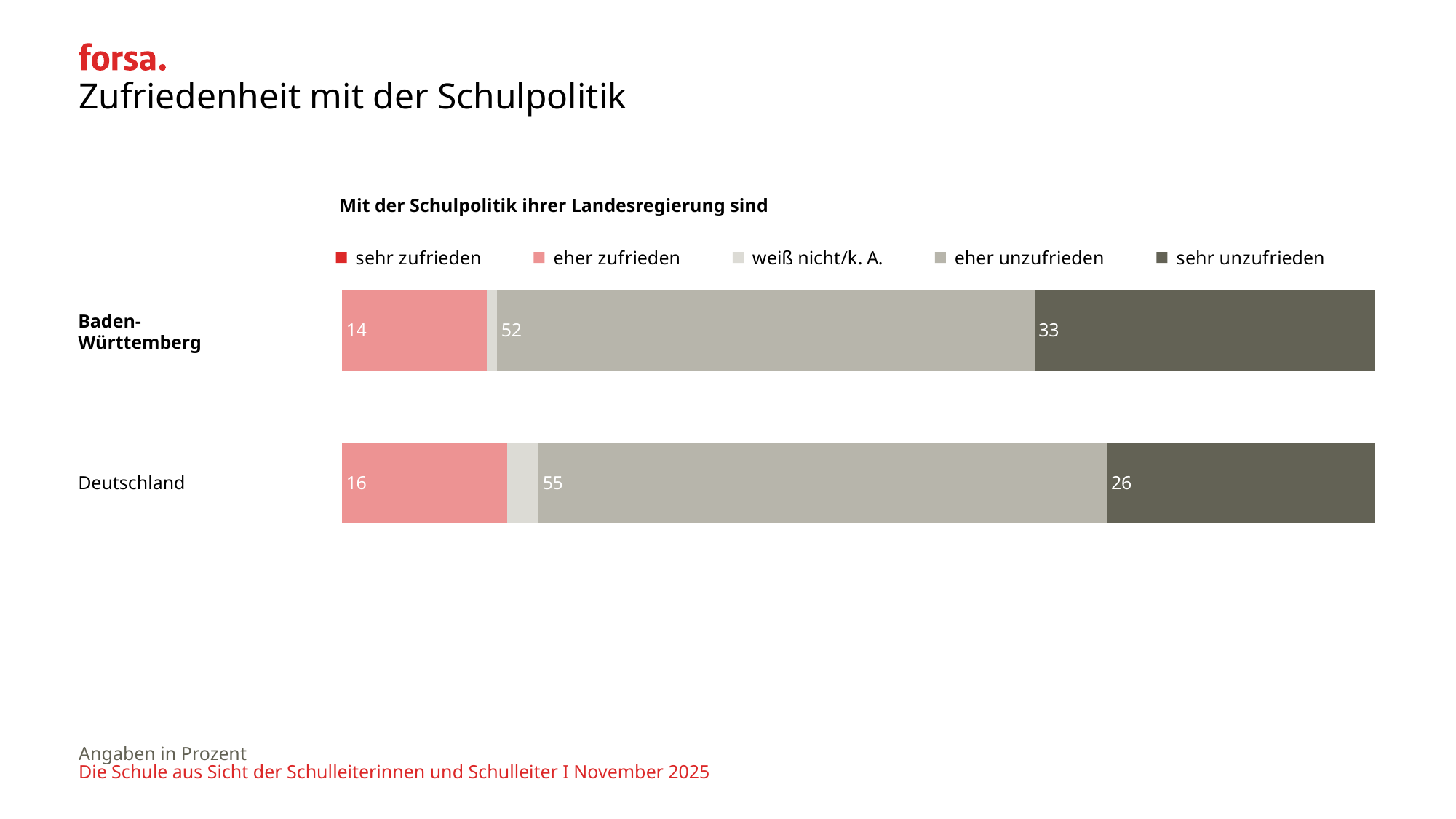
What is the value for "sehr unzufrieden" for Deutschland? 26 What is the difference between the "eher unzufrieden" values for Deutschland and Baden-Württemberg? 3 What is the value for "eher unzufrieden" for Deutschland? 55 How many series does the legend list? 5 What kind of chart is shown on the slide? Stacked bar chart What is the value for "eher zufrieden" for Deutschland? 16 What is the value for "eher unzufrieden" for Baden-Württemberg? 52 Which category has the higher value for "sehr unzufrieden", Baden-Württemberg or Deutschland? Baden-Württemberg What is the difference between the "sehr unzufrieden" values for Baden-Württemberg and Deutschland? 7 Which segment is the largest in the Baden-Württemberg bar? eher unzufrieden How many categories (bars) are shown in the chart? 2 What is the value for "eher zufrieden" for Baden-Württemberg? 14